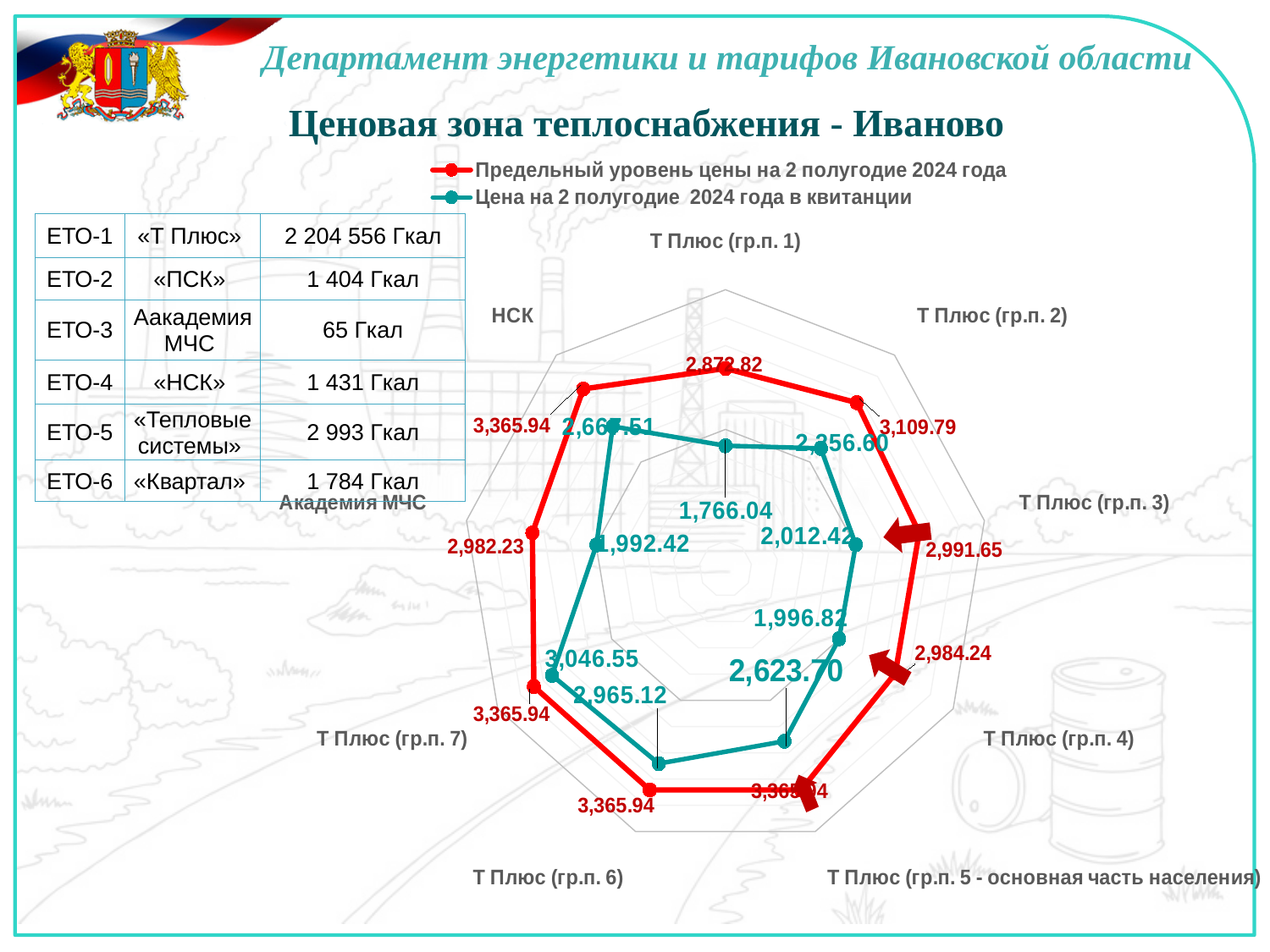
What type of chart is shown on the slide? Radar chart For Т Плюс (гр.п. 3), what is the difference between 'Предельный уровень цены' (2,991.65) and 'Цена в квитанции' (2,012.42)? 979.23 Which category has the lowest value for 'Цена на 2 полугодие 2024 года в квитанции'? Т Плюс (гр.п. 1) How many categories (axes) does the radar chart have? 9 What is the value of 'Предельный уровень цены на 2 полугодие 2024 года' for Академия МЧС? 2,982.23 For the series 'Цена на 2 полугодие 2024 года в квитанции', which is larger: Т Плюс (гр.п. 7) or Т Плюс (гр.п. 6)? Т Плюс (гр.п. 7) What is the value of 'Предельный уровень цены на 2 полугодие 2024 года' for Т Плюс (гр.п. 2)? 3,109.79 Which category has the highest value for 'Цена на 2 полугодие 2024 года в квитанции'? Т Плюс (гр.п. 7) How many series does the chart legend list? 2 What is the value of 'Цена на 2 полугодие 2024 года в квитанции' for Т Плюс (гр.п. 1)? 1,766.04 What is the value of 'Цена на 2 полугодие 2024 года в квитанции' for Т Плюс (гр.п. 7)? 3,046.55 What is the value of 'Цена на 2 полугодие 2024 года в квитанции' for Т Плюс (гр.п. 5 - основная часть населения)? 2,623.70